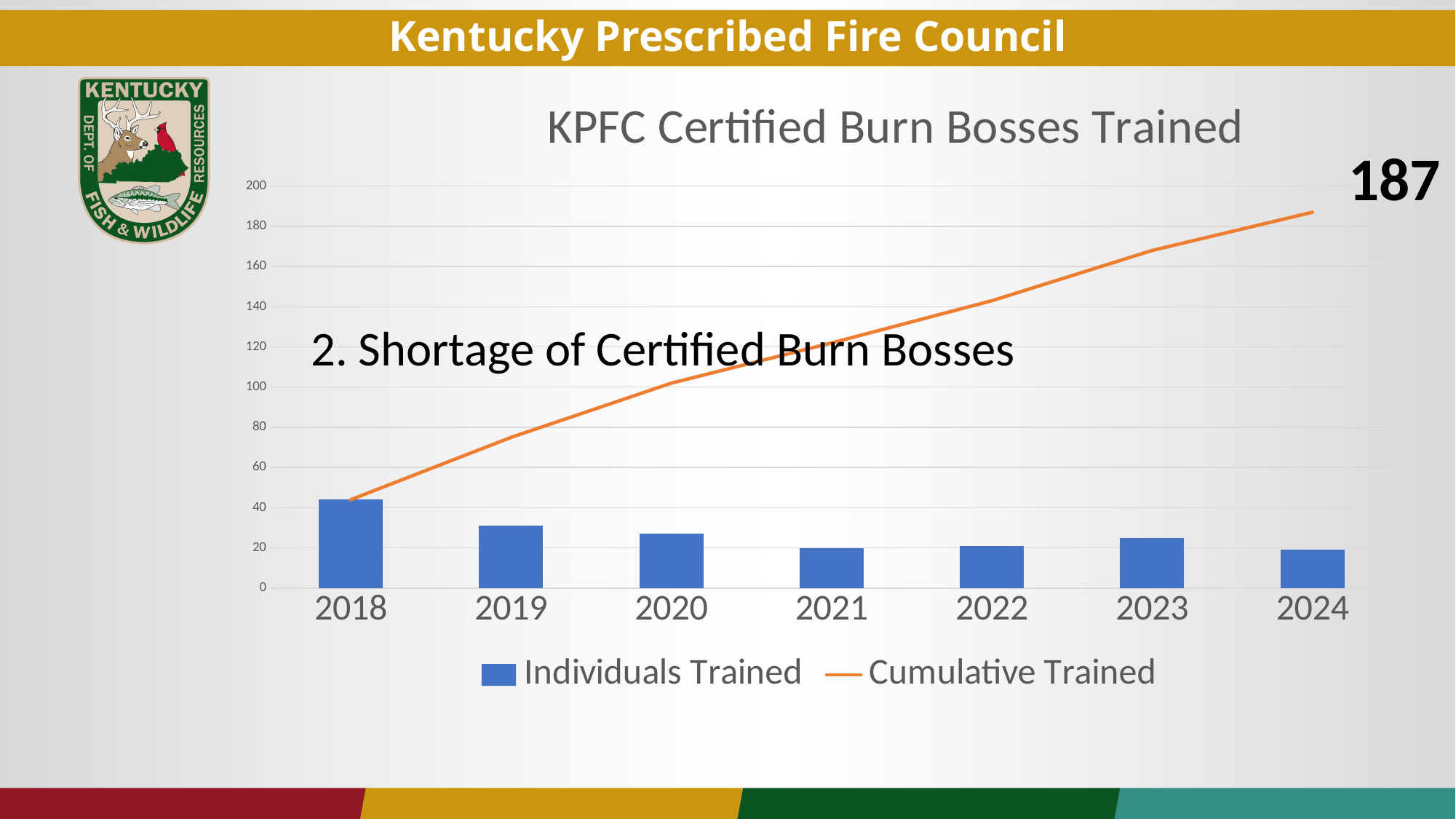
Does the Cumulative Trained line rise or fall from 2018 to 2024? rise What kind of chart is shown on the slide? A combined bar and line chart What is the title of the chart? KPFC Certified Burn Bosses Trained Is the Cumulative Trained value for 2023 greater or less than 160? greater Which year has the highest Individuals Trained bar? 2018 Is the Individuals Trained value for 2018 greater or less than 40? greater How many series does the chart legend list? 2 What colour are the Individuals Trained bars? Blue Which is larger, the Individuals Trained value for 2018 or for 2019? 2018 Is the Individuals Trained value for 2021 greater or less than 40? less What is the Cumulative Trained value labelled at the end of the line in 2024? 187 How many years are shown on the x axis of the chart? 7